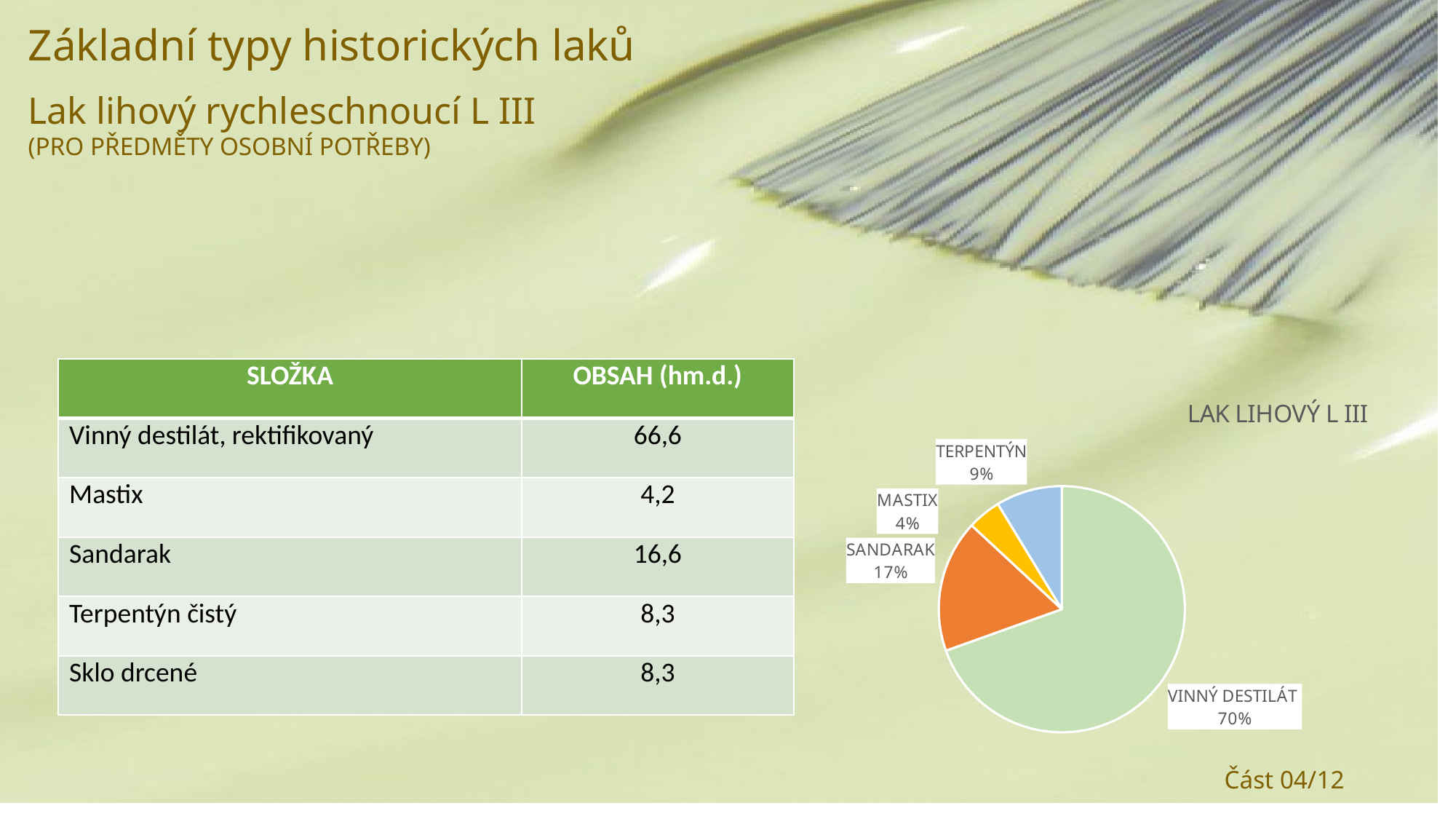
What share of the pie chart does MASTIX have? 4% Which slice of the pie chart is the smallest? MASTIX What share of the pie chart does VINNÝ DESTILÁT have? 70% What share of the pie chart does SANDARAK have? 17% Which slice of the pie chart is the largest? VINNÝ DESTILÁT What is the difference in percentage points between the SANDARAK and TERPENTÝN slices? 8 What colour is the VINNÝ DESTILÁT slice in the pie chart? light green What is the title of the pie chart? LAK LIHOVÝ L III How many slices does the pie chart have? 4 What type of chart is shown on the slide? pie chart Which slice is larger, SANDARAK or TERPENTÝN? SANDARAK